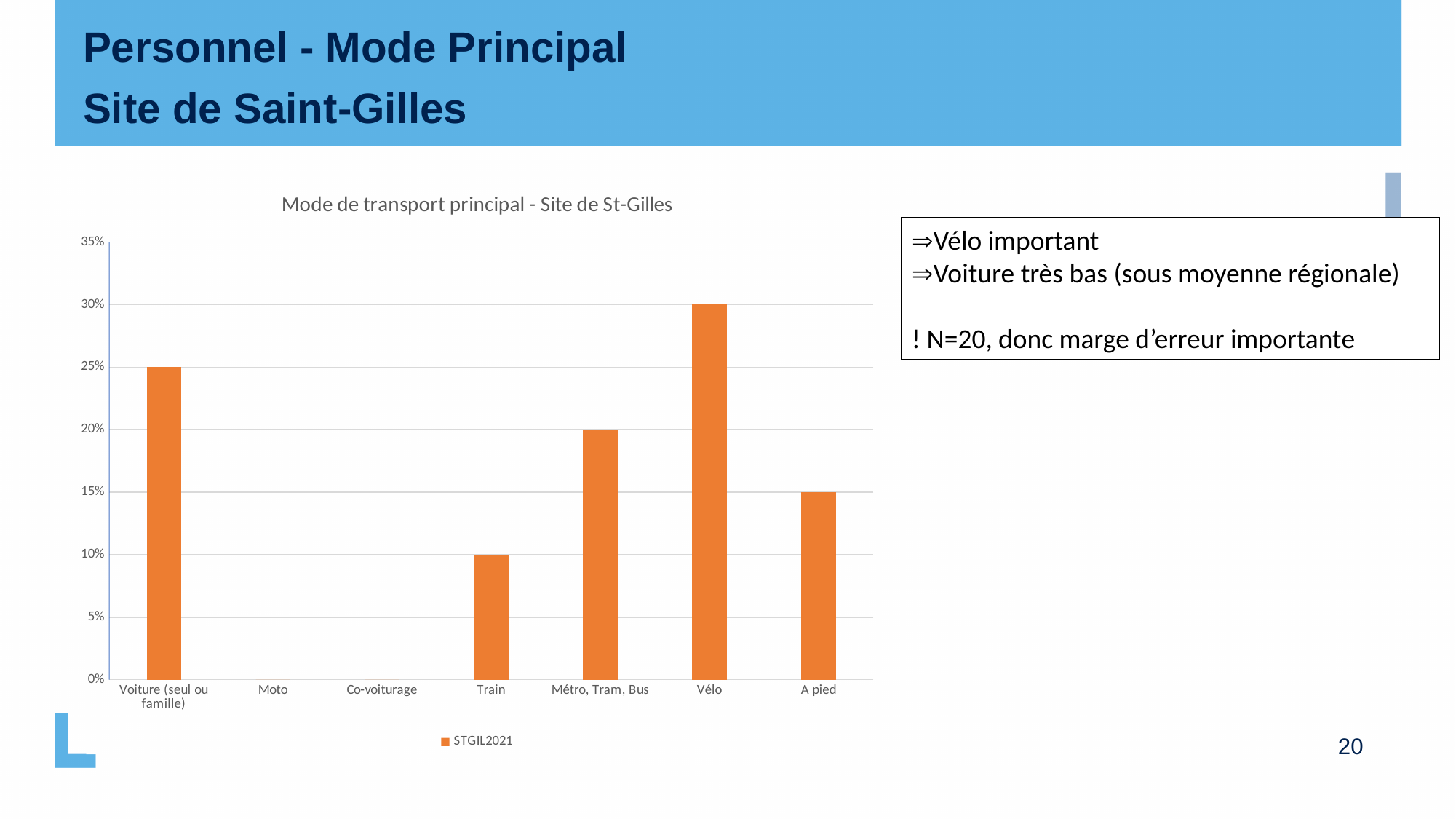
What is the value for Train? 10% Is the value for A pied greater or less than 20%? less What is the value for Vélo? 30% What is the value for Voiture (seul ou famille)? 25% What is the difference between the values for Vélo and Voiture (seul ou famille)? 5% What type of chart is shown on the slide? bar chart What is the title of the chart? Mode de transport principal - Site de St-Gilles Which of Train or A pied has the larger value? A pied How many categories are shown on the x axis? 7 What is the value for Métro, Tram, Bus? 20% Which category has the highest value? Vélo How many series does the legend list? 1